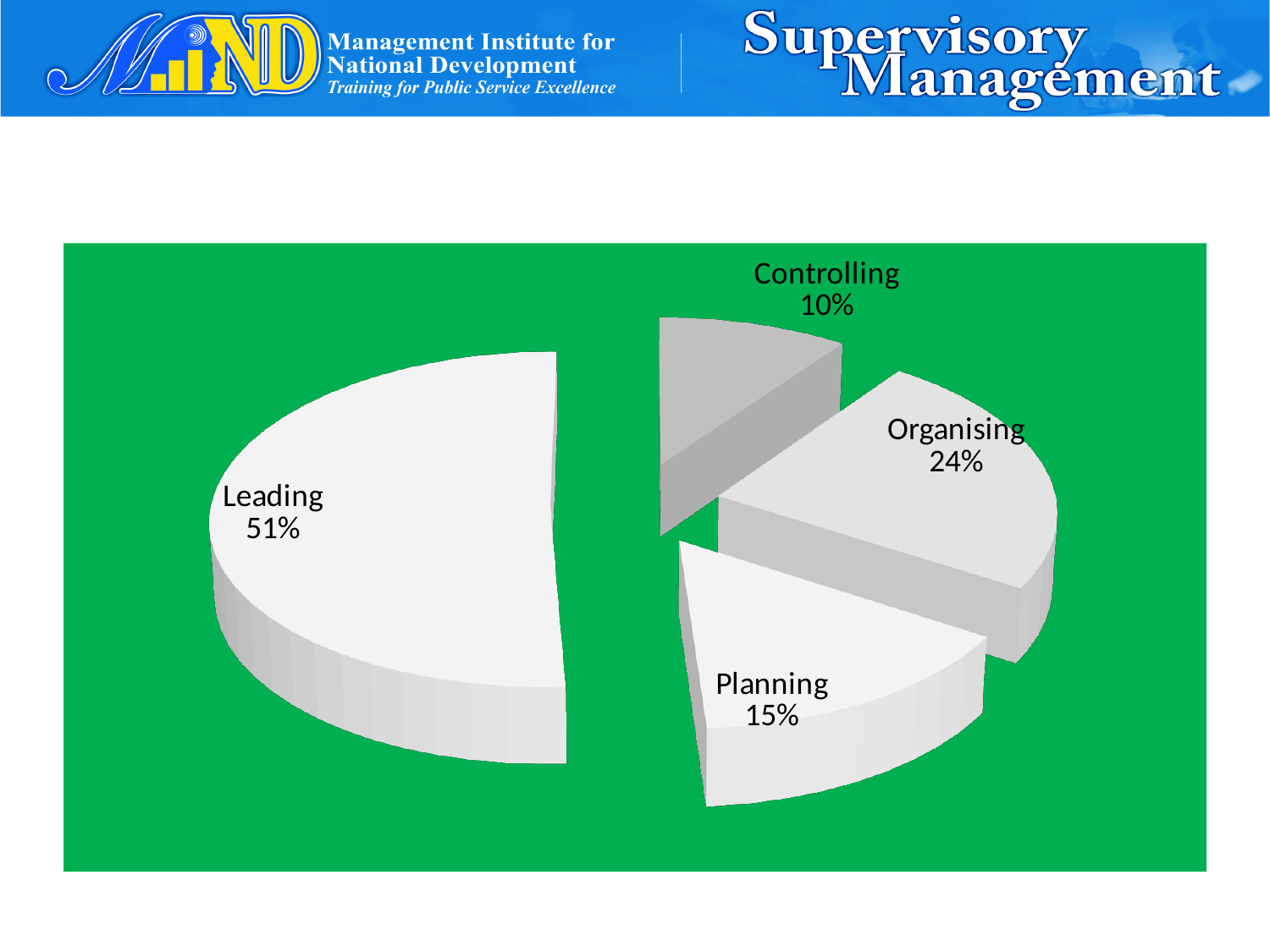
What is the difference in percentage points between Leading and Organising? 27 Which category has the smallest share of the pie? Controlling How many slices does the pie chart have? 4 Which category has the largest share of the pie? Leading What percentage does the Planning slice represent? 15% What is the difference in percentage points between Planning and Controlling? 5 Which is larger, the Organising slice or the Planning slice? Organising What kind of chart is shown on the slide? pie chart What percentage does the Leading slice represent? 51% What percentage does the Organising slice represent? 24% What percentage does the Controlling slice represent? 10% What is the background colour of the chart area? green